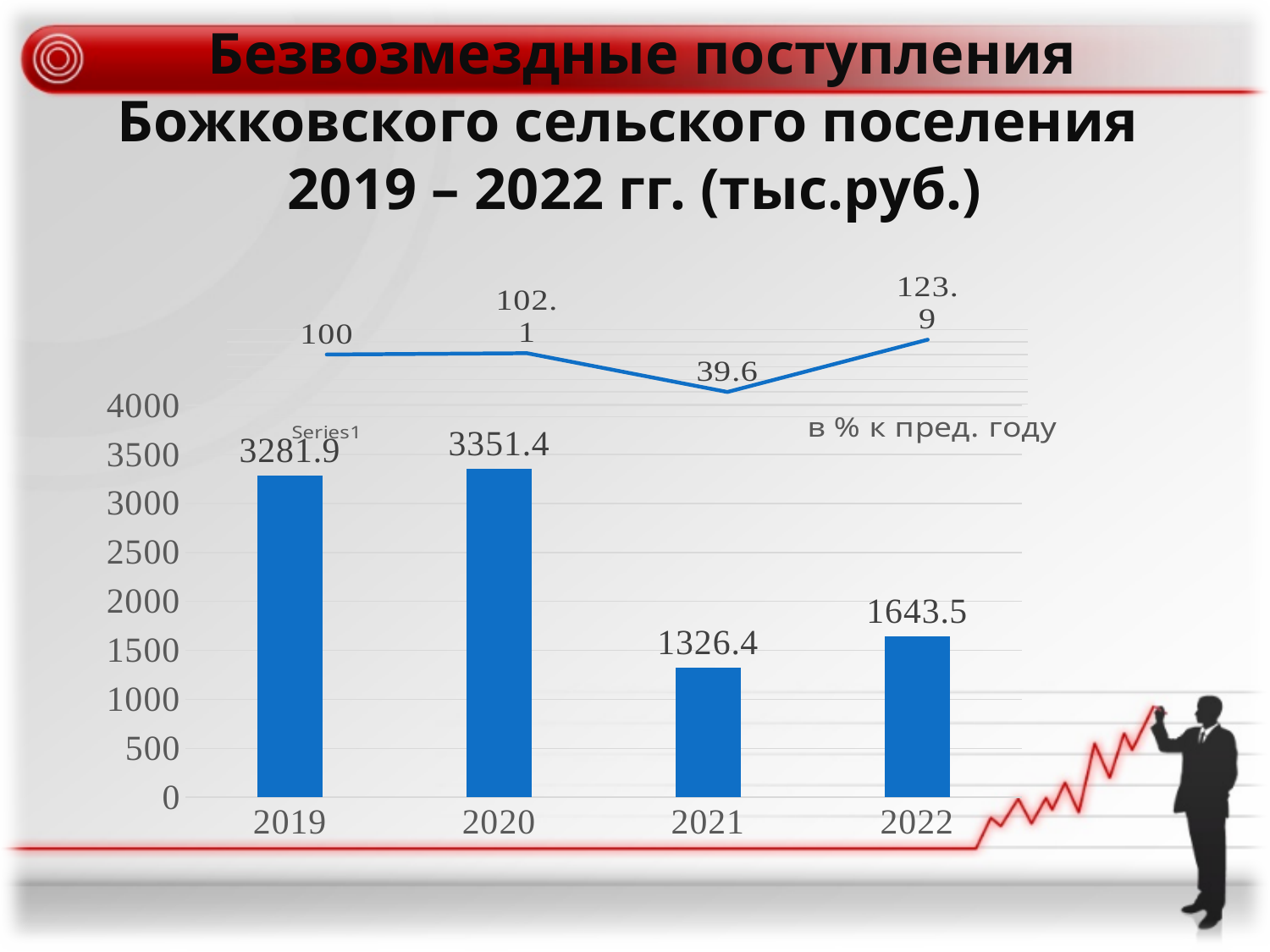
What is the value of the line (в % к пред. году) for 2021? 39.6 Which year has the lowest bar? 2021 What kind of chart shows the values 3281.9, 3351.4, 1326.4 and 1643.5? bar chart What is the value of the line (в % к пред. году) for 2022? 123.9 What is the difference between the bar values for 2020 and 2019? 69.5 Is the bar value for 2022 greater or less than 1500? greater Which year has the highest bar? 2020 What is the value of the bar for 2020? 3351.4 How many years are shown on the x axis? 4 What is the value of the bar for 2021? 1326.4 Which bar is larger, 2019 or 2022? 2019 What is the difference between the bar values for 2022 and 2021? 317.1